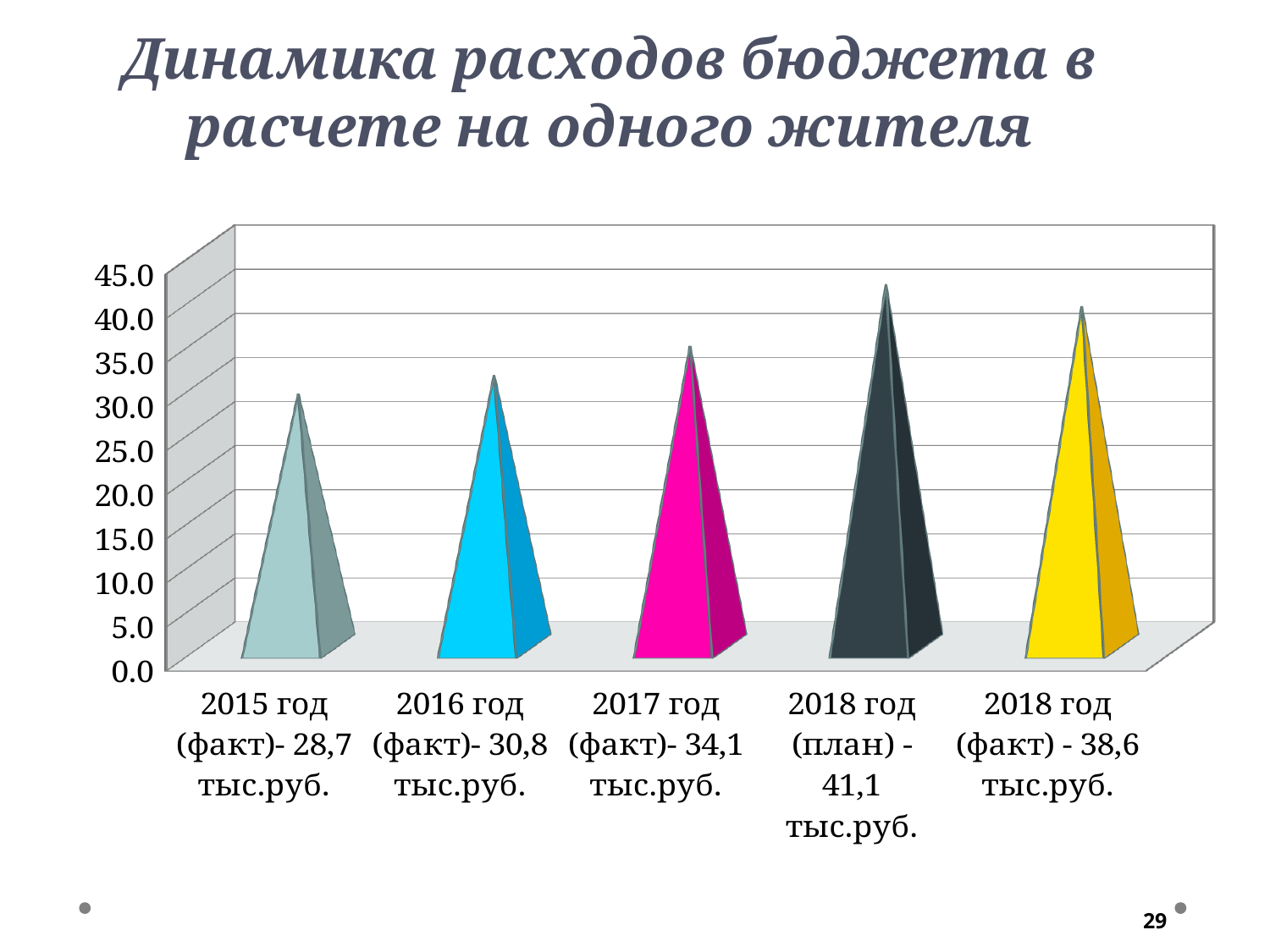
What value is shown for 2015 год (факт)? 28,7 тыс.руб. Which is larger, the value for 2017 год (факт) or the value for 2016 год (факт)? 2017 год (факт) What is the title of the chart on the slide? Динамика расходов бюджета в расчете на одного жителя What value is shown for 2018 год (план)? 41,1 тыс.руб. Is the value for 2018 год (факт) greater or less than 35.0? greater What is the difference between the 2016 год (факт) value and the 2015 год (факт) value? 2,1 тыс.руб. How many categories are shown on the chart? 5 What is the difference between the 2018 год (план) value and the 2018 год (факт) value? 2,5 тыс.руб. Which category has the highest value? 2018 год (план) What value is shown for 2017 год (факт)? 34,1 тыс.руб. Which category has the lowest value? 2015 год (факт) What kind of chart is shown on the slide? bar chart